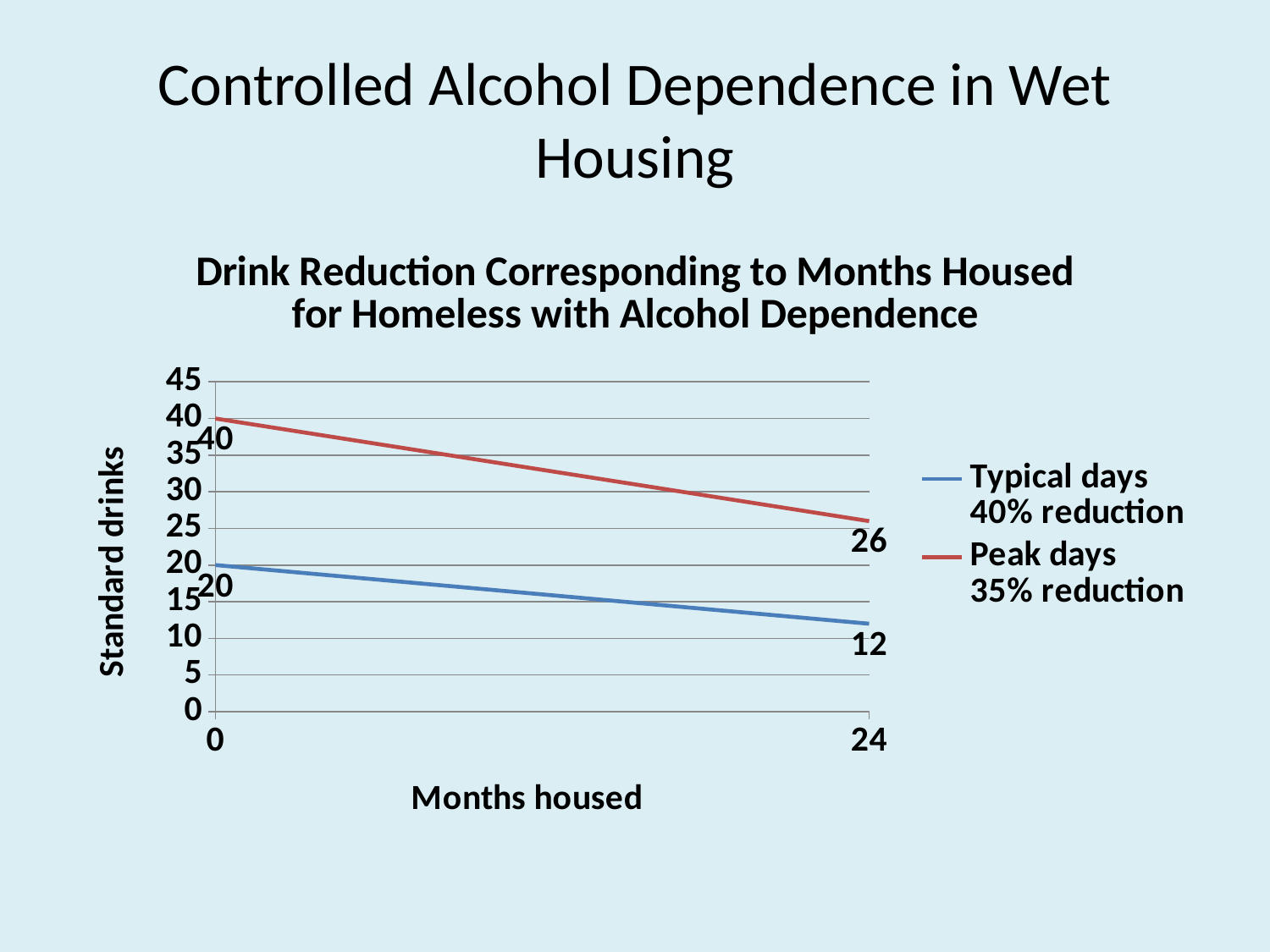
What kind of chart is shown on the slide? line chart What is the value for Peak days 35% reduction at 0 months housed? 40 How many points on the x axis (months housed) are plotted for each series? 2 By how much does the Typical days 40% reduction series fall from 0 to 24 months housed? 8 At 24 months housed, which series has the higher value, Typical days 40% reduction or Peak days 35% reduction? Peak days 35% reduction What is the value for Typical days 40% reduction at 24 months housed? 12 What is the value for Typical days 40% reduction at 0 months housed? 20 By how much does the Peak days 35% reduction series fall from 0 to 24 months housed? 14 How many series does the legend list? 2 What is the value for Peak days 35% reduction at 24 months housed? 26 What is the label of the y axis? Standard drinks Do the values for Peak days 35% reduction rise or fall as months housed increases? fall